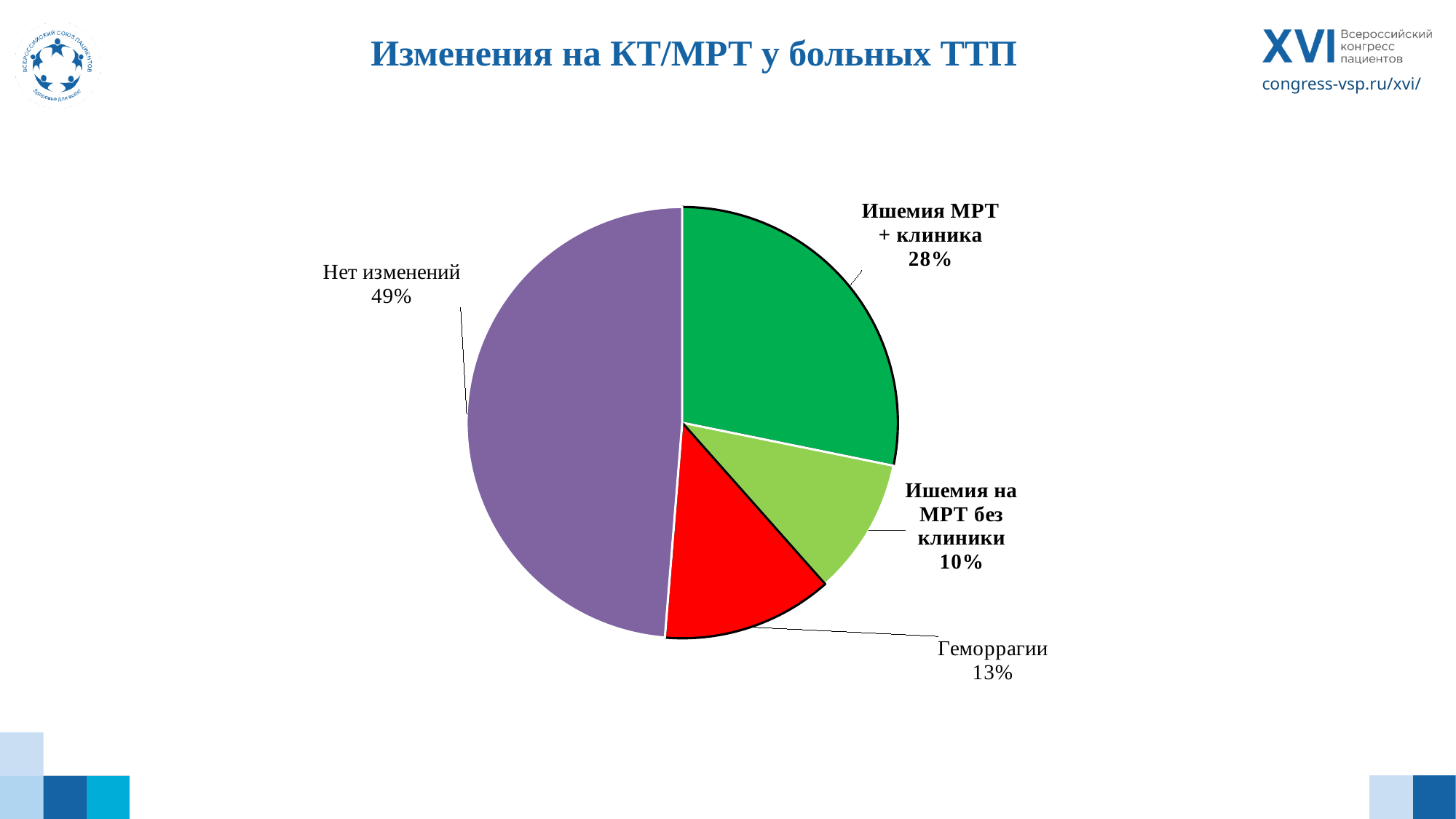
Which slice of the pie is the smallest? Ишемия на МРТ без клиники What share of the pie is labelled "Ишемия на МРТ без клиники"? 10% What share of the pie is labelled "Геморрагии"? 13% What share of the pie is labelled "Ишемия МРТ + клиника"? 28% What kind of chart is shown on the slide? pie chart How many slices does the pie chart have? 4 What colour is the "Геморрагии" slice? red What is the difference in percentage points between "Нет изменений" and "Ишемия МРТ + клиника"? 21 Which is larger: the share for "Геморрагии" or the share for "Ишемия на МРТ без клиники"? Геморрагии Which slice of the pie is the largest? Нет изменений What is the title of the slide above the chart? Изменения на КТ/МРТ у больных ТТП